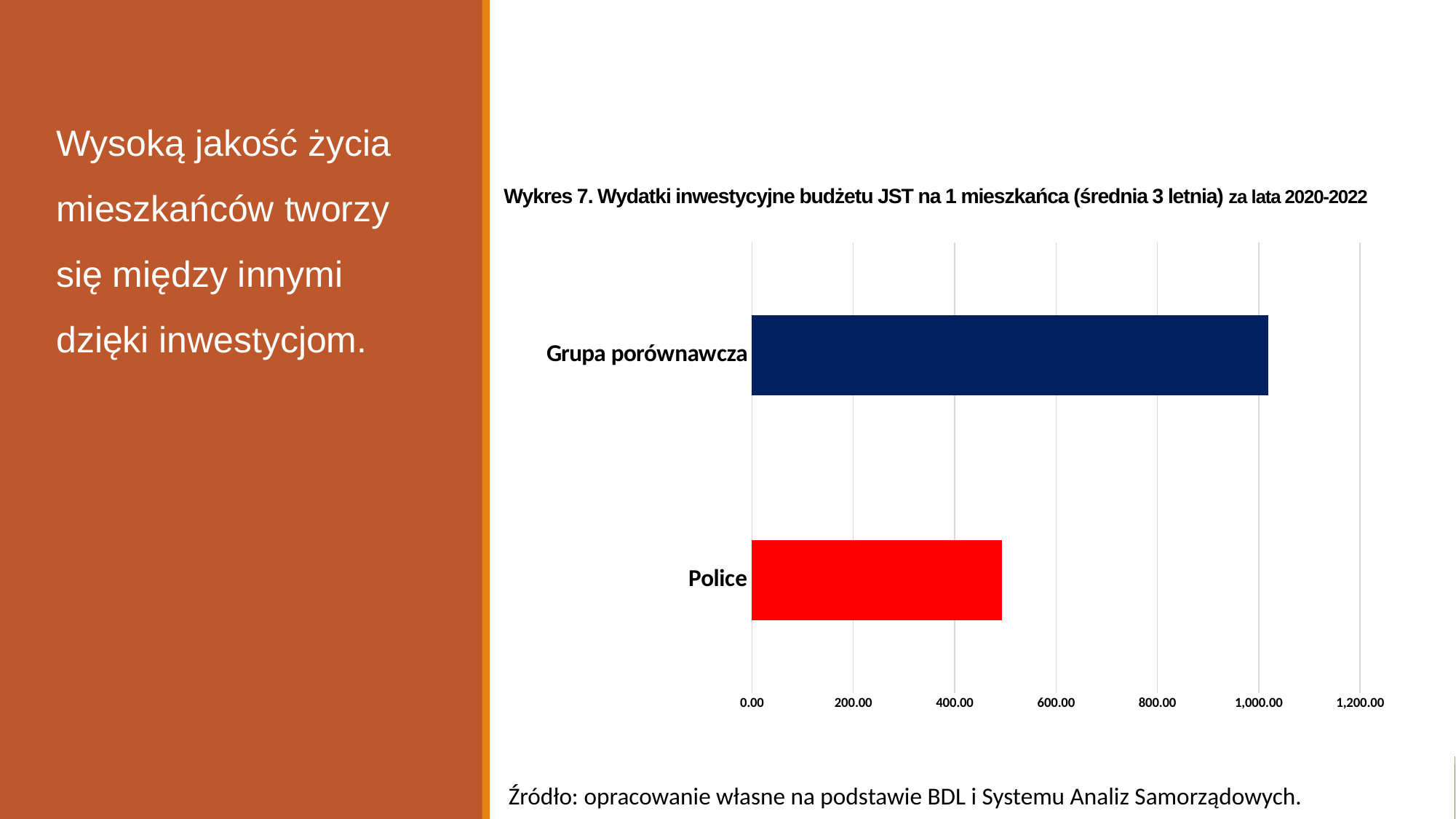
Is the value for Grupa porównawcza greater or less than 800.00? greater Is the value for Police greater or less than 400.00? greater Is the value for Grupa porównawcza greater or less than 1,200.00? less What kind of chart is shown on the slide? bar chart How many categories are plotted in the chart? 2 Which category has the highest value in the chart? Grupa porównawcza What is the title of the chart? Wykres 7. Wydatki inwestycyjne budżetu JST na 1 mieszkańca (średnia 3 letnia) za lata 2020-2022 What colour is the bar for Police? red Which is larger, the value for Police or the value for Grupa porównawcza? Grupa porównawcza Which category has the lowest value in the chart? Police